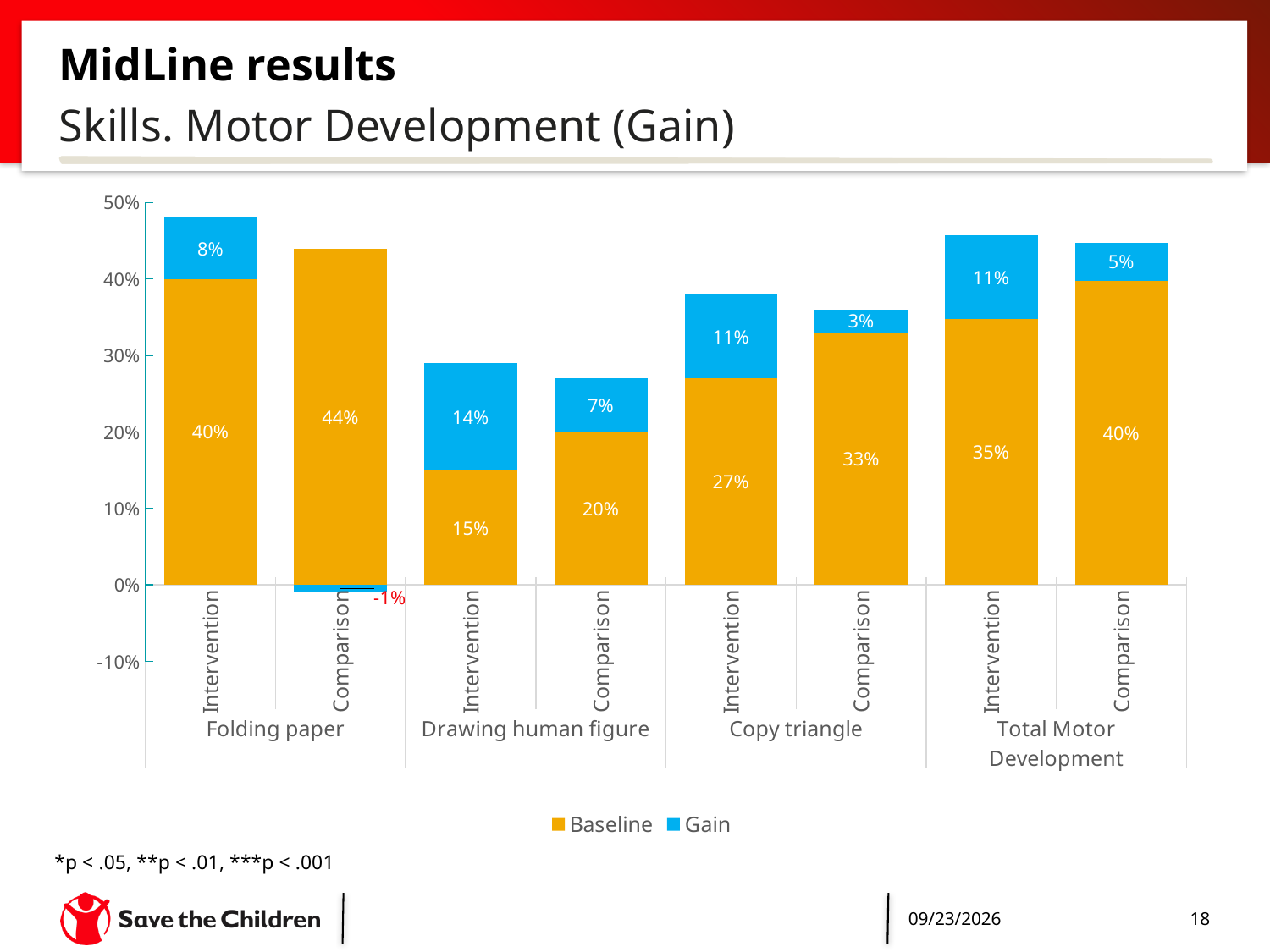
What is the Gain value for the Comparison group in Drawing human figure? 7% Which bar has the lowest Baseline value? Drawing human figure, Intervention How many series does the legend list? 2 How many bars are plotted in the chart? 8 What type of chart is shown on the slide? Stacked bar chart Which is larger, the Baseline value for Intervention or for Comparison in Total Motor Development? Comparison What is the total of the stacked bar for the Intervention group in Folding paper? 48% What is the Baseline value for the Intervention group in Folding paper? 40% What is the Gain value for the Comparison group in Folding paper? -1% What is the Gain value for the Intervention group in Total Motor Development? 11% What is the difference between the Gain values for Intervention and Comparison in Copy triangle? 8% Which bar has the highest Gain value? Drawing human figure, Intervention